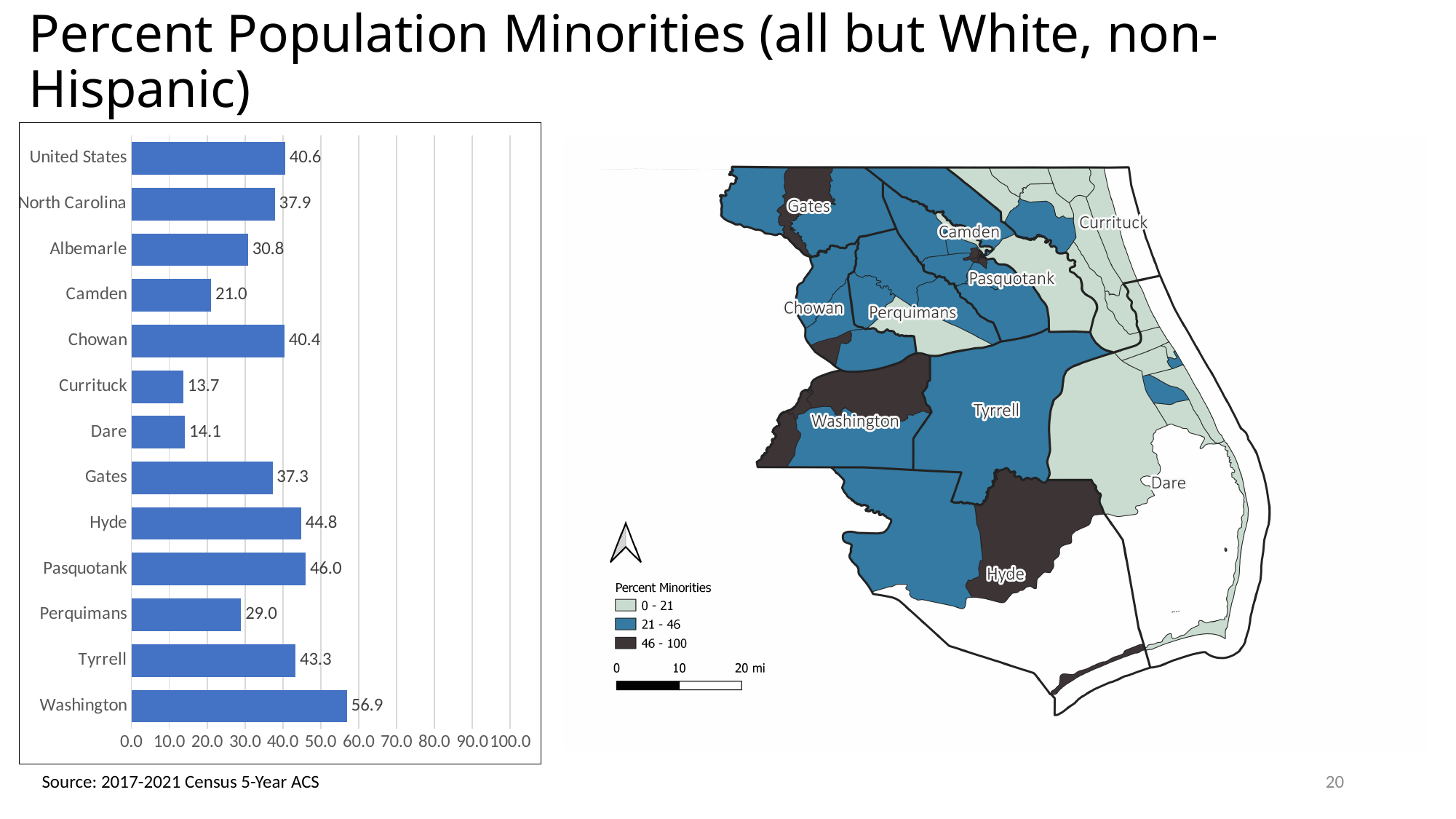
In the bar chart, what is the difference between the values for the United States and Albemarle? 9.8 What is the value shown for Currituck in the bar chart? 13.7 How many categories are shown in the bar chart? 13 What is the highest value shown on the x axis of the bar chart? 100.0 What is the value shown for North Carolina in the bar chart? 37.9 What kind of chart is shown on the left of the slide? bar chart In the bar chart, is the value for Pasquotank greater or less than 40.0? greater In the bar chart, what is the difference between the values for Washington and Camden? 35.9 Which category has the highest value in the bar chart? Washington What is the percent population minorities value for Washington in the bar chart? 56.9 In the bar chart, which is larger, the value for Hyde or the value for Tyrrell? Hyde Which category has the lowest value in the bar chart? Currituck